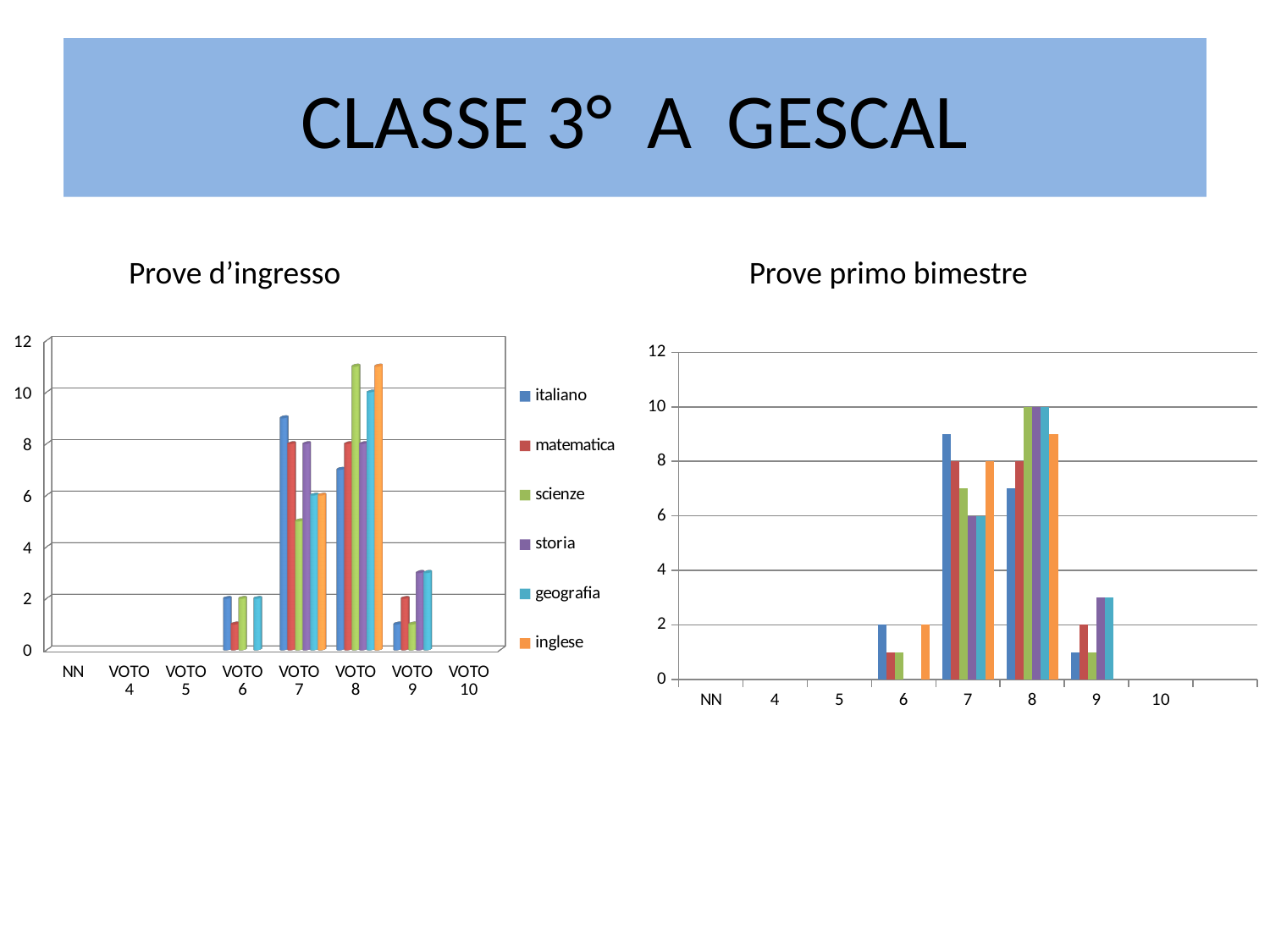
In the 'Prove d’ingresso' chart, is the value for storia at VOTO 9 greater or less than 4? less How many categories are shown on the x axis of the 'Prove d’ingresso' chart? 8 In the 'Prove d’ingresso' chart, is the value for italiano larger at VOTO 7 or at VOTO 8? VOTO 7 In the 'Prove primo bimestre' chart, which categories have no bars at all? NN, 4, 5, 10 How many categories are shown on the x axis of the 'Prove primo bimestre' chart? 8 In the 'Prove d’ingresso' chart, is the value for scienze at VOTO 8 greater or less than 10? greater In the 'Prove primo bimestre' chart, is the tallest bar at category 8 greater or less than 8? greater What are the legend entries of the 'Prove d’ingresso' chart? italiano, matematica, scienze, storia, geografia, inglese In the 'Prove d’ingresso' chart, which series has the highest value at VOTO 7? italiano What kind of chart is the 'Prove d’ingresso' chart on the left? bar chart How many series does the legend of the 'Prove d’ingresso' chart list? 6